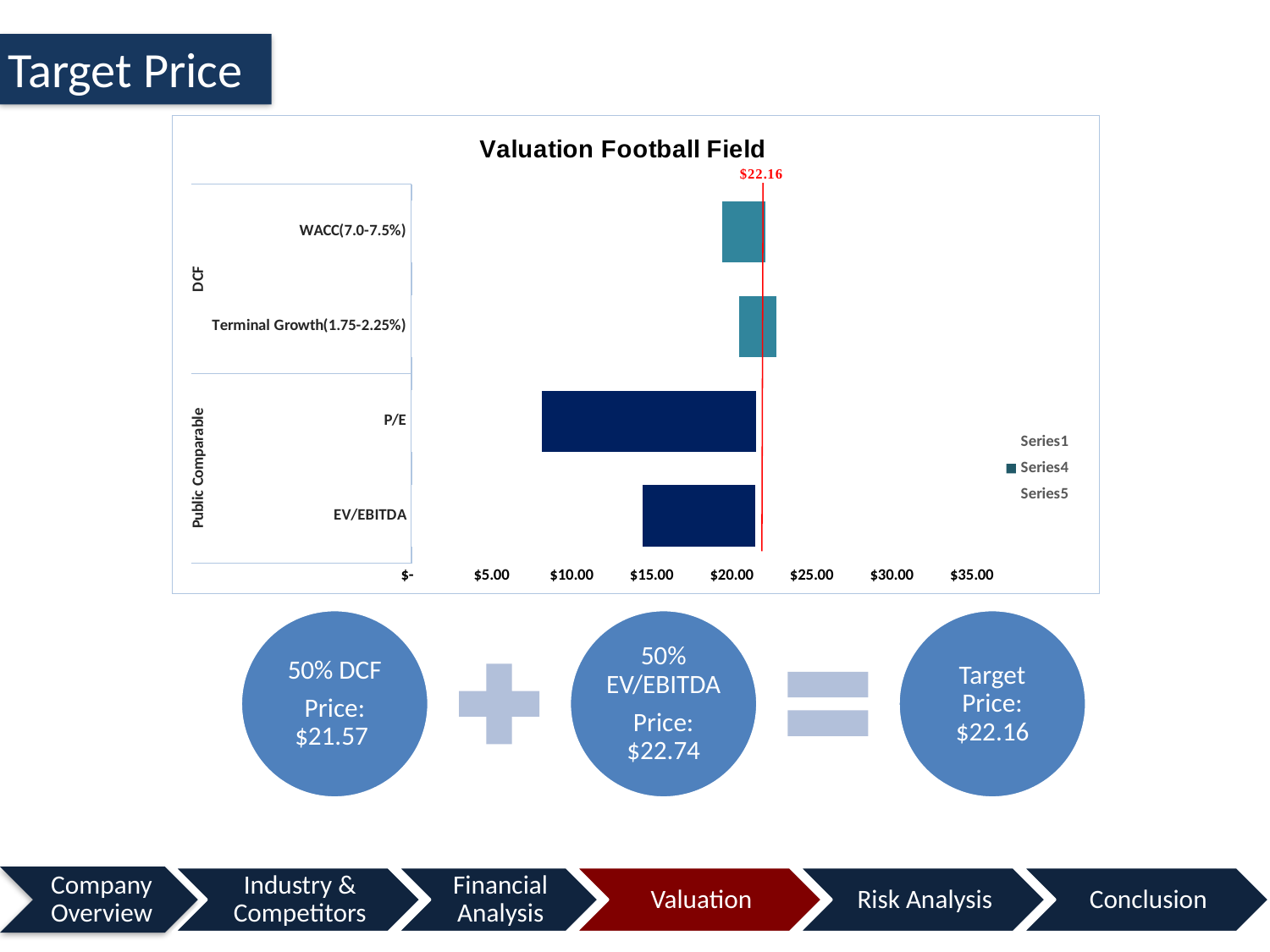
What type of chart is the Valuation Football Field? bar chart In the Valuation Football Field chart, is the lower end of the P/E range greater or less than $10.00? less What is the title of the chart on the slide? Valuation Football Field Which category in the Valuation Football Field chart has the lowest starting value of its range? P/E Which category in the Valuation Football Field chart has the widest valuation range? P/E How many valuation categories are plotted in the Valuation Football Field chart? 4 In the Valuation Football Field chart, is the upper end of the WACC(7.0-7.5%) range greater or less than $25.00? less In the Valuation Football Field chart, is the lower end of the EV/EBITDA range greater or less than $10.00? greater What are the legend entries shown in the Valuation Football Field chart? Series1, Series4, Series5 What value is labelled on the red vertical line in the Valuation Football Field chart? $22.16 How many series does the legend of the Valuation Football Field chart list? 3